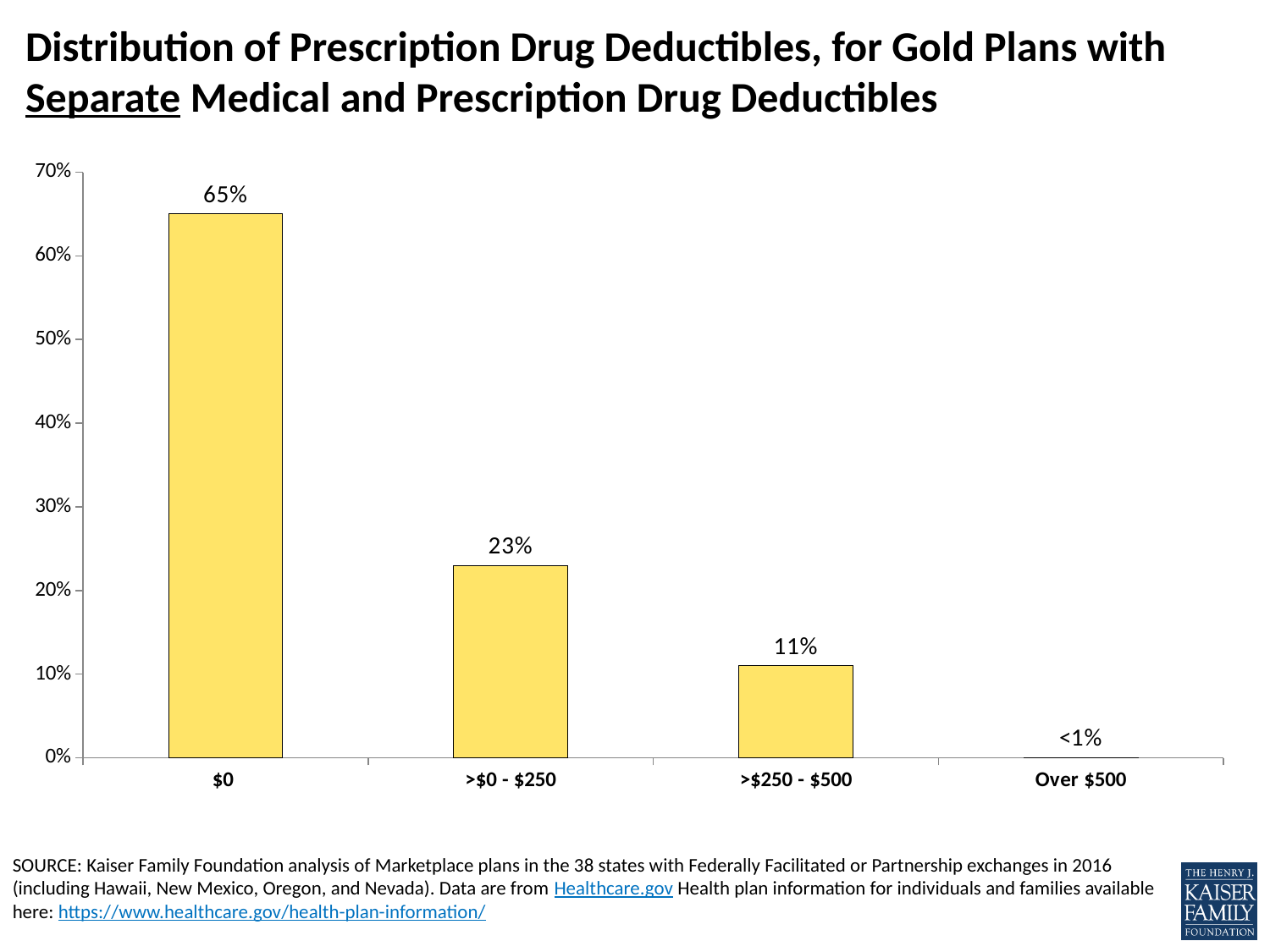
What percentage of gold plans with separate deductibles have a $0 prescription drug deductible? 65% Which deductible category has the highest share of plans? $0 Which is larger, the value for >$0 - $250 or the value for >$250 - $500? >$0 - $250 How many deductible categories are shown on the x axis? 4 What is the difference in percentage points between the >$0 - $250 category and the >$250 - $500 category? 12 What is the value shown for the >$250 - $500 category? 11% What is the difference in percentage points between the $0 category and the >$0 - $250 category? 42 What is the data label shown for the Over $500 category? <1% What is the value shown for the >$0 - $250 category? 23% Which deductible category has the lowest share of plans? Over $500 Do the values rise or fall moving from left to right along the x axis? Fall What kind of chart is shown on the slide? Bar chart